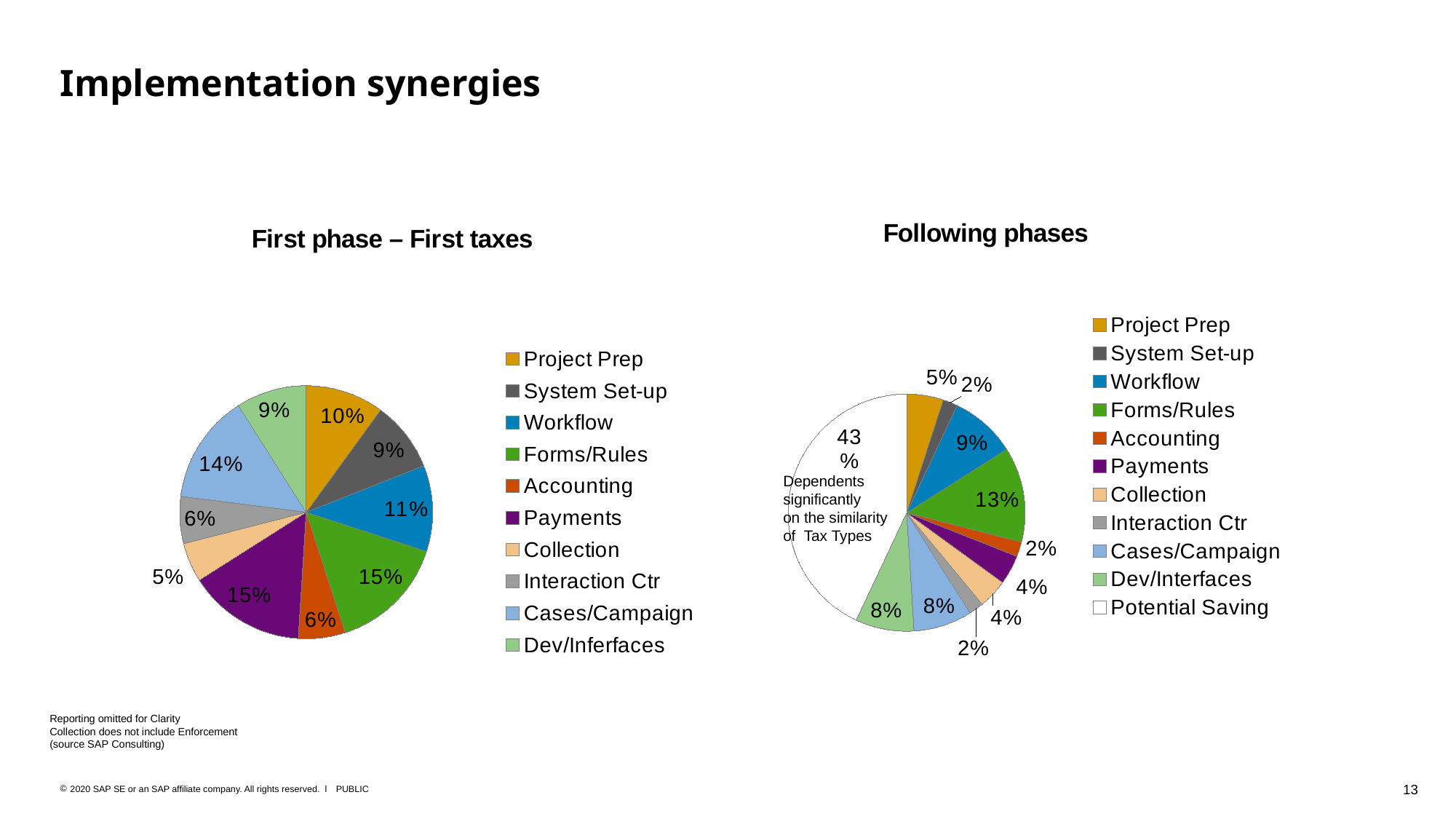
In the "Following phases" chart, which category has the largest share? Potential Saving In the "Following phases" chart, what percentage is Forms/Rules? 13% How many slices does the "First phase – First taxes" pie have? 10 In the "Following phases" chart, what percentage is Potential Saving? 43% In the "First phase – First taxes" chart, which category has the smallest share? Collection In the "First phase – First taxes" chart, what percentage is Workflow? 11% Which legend entry appears in the "Following phases" chart but not in the "First phase – First taxes" chart? Potential Saving In the "Following phases" chart, which is larger, Workflow or Cases/Campaign? Workflow What kind of chart is used for "First phase – First taxes"? Pie chart In the "First phase – First taxes" chart, what is the difference between the Payments share and the Accounting share? 9% In the "First phase – First taxes" chart, what percentage is Cases/Campaign? 14% How many categories does the legend of the "Following phases" chart list? 11